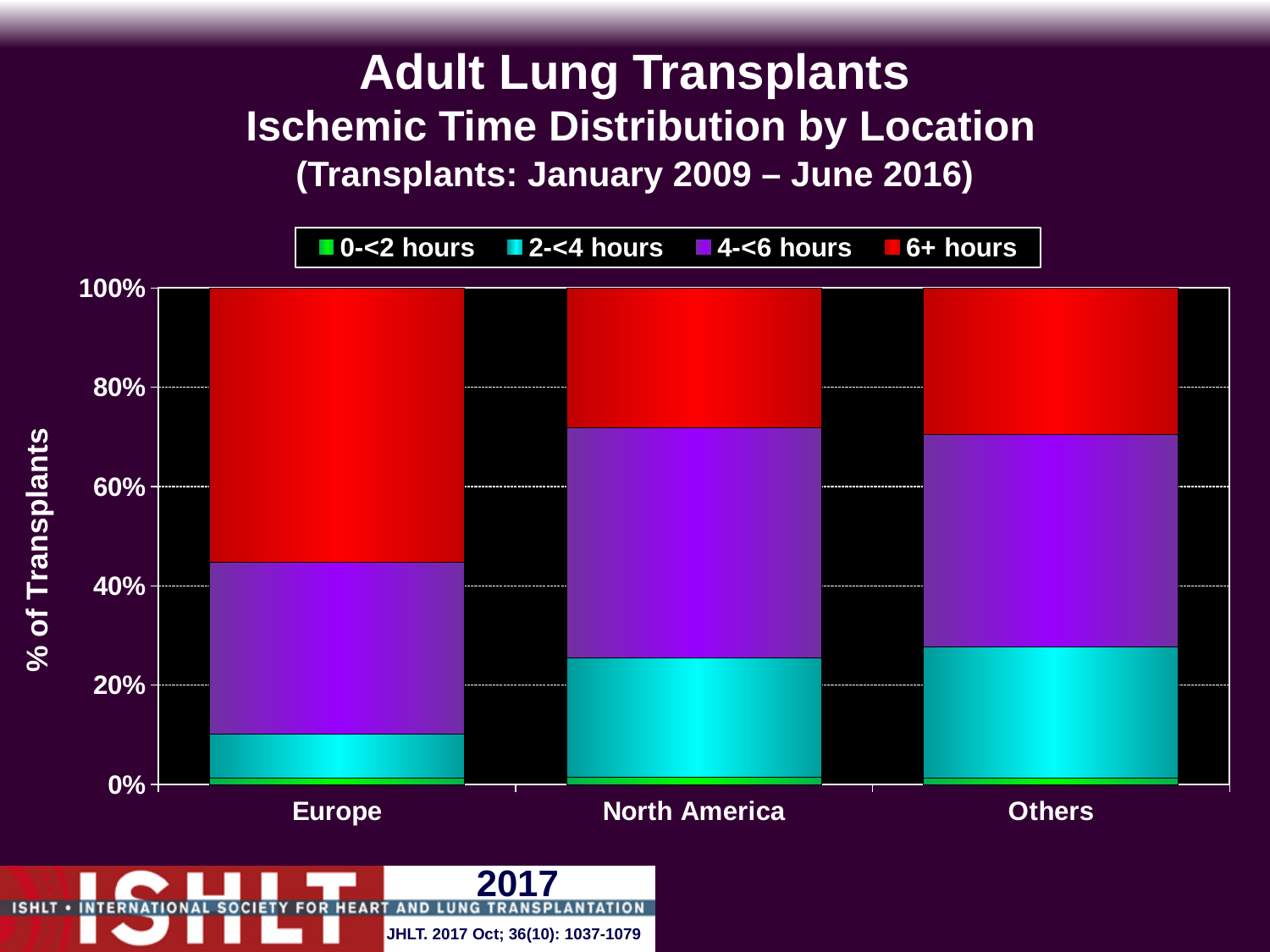
How many series does the legend list? 4 Is the 6+ hours share for Europe greater or less than 40%? greater Which is larger, the 6+ hours share for Europe or for North America? Europe What kind of chart is shown on the slide? Stacked bar chart Is the 2-<4 hours share for Others greater or less than 20%? greater Which location has the largest 6+ hours share? Europe What is the label of the y axis? % of Transplants How many locations are shown on the x axis? 3 Is the 6+ hours share for North America greater or less than 40%? less Which ischemic time category makes up the largest share of the North America bar? 4-<6 hours Which location has the smallest 2-<4 hours share? Europe